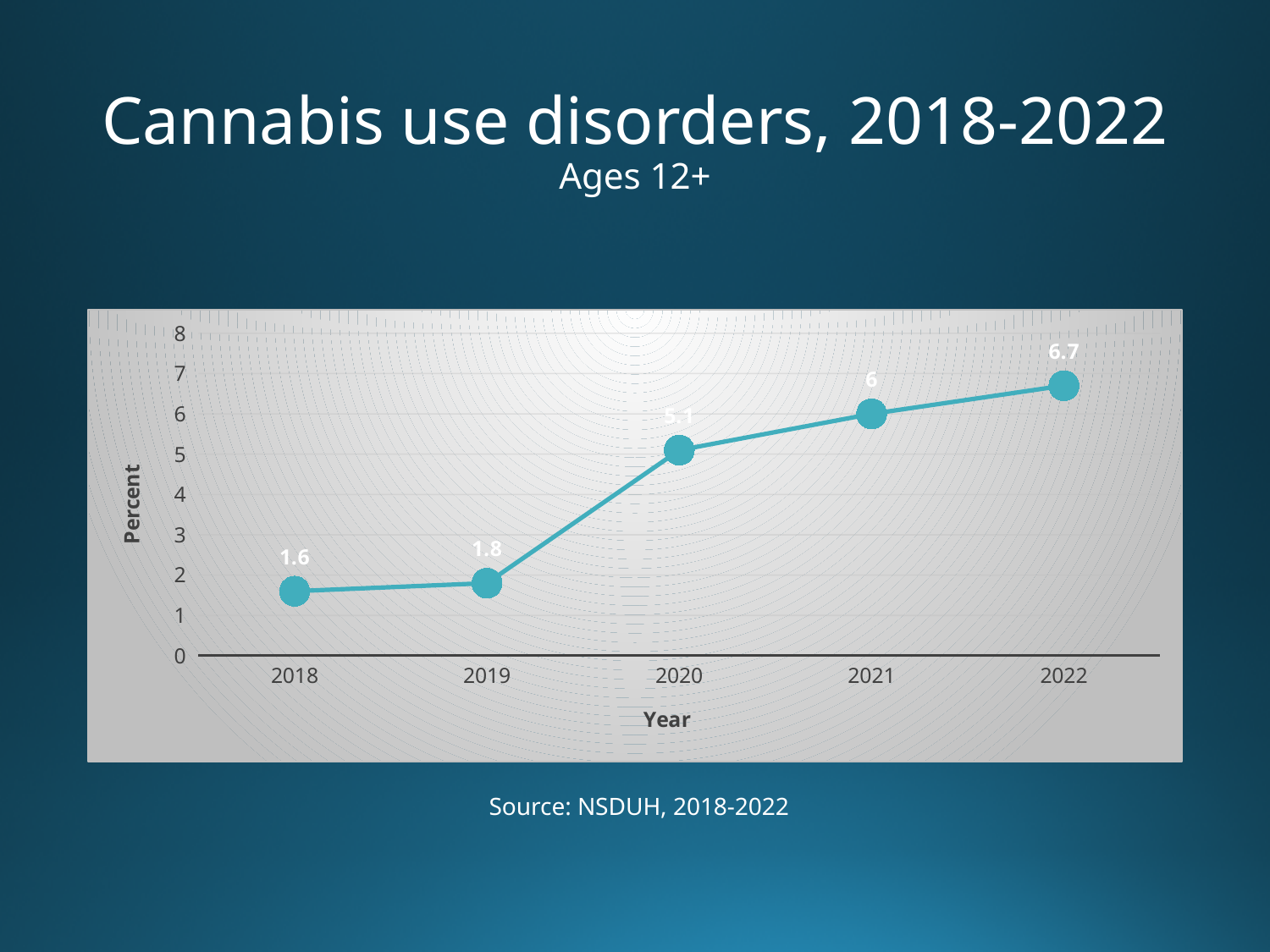
Which is larger, the value for 2021 or the value for 2019? 2021 What is the value for 2018? 1.6 How many years are plotted on the chart? 5 What is the value for 2020? 5.1 What is the difference between the values for 2020 and 2019? 3.3 Do the values rise or fall from 2018 to 2022? rise What is the value for 2022? 6.7 What kind of chart is shown on the slide? line chart What is the difference between the values for 2022 and 2018? 5.1 Is the value for 2021 greater or less than 5? greater Which year has the lowest value? 2018 Which year has the highest value? 2022